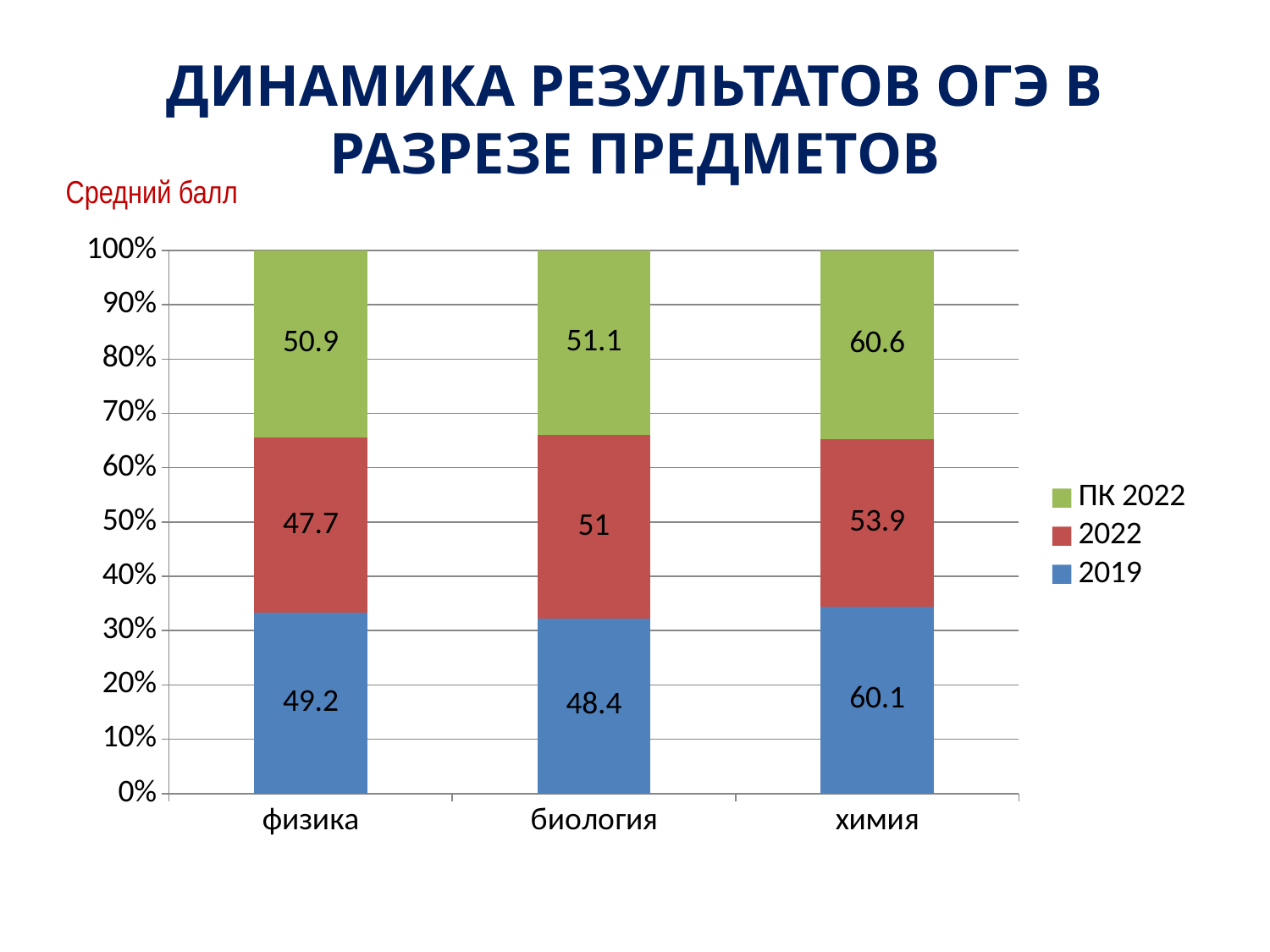
What kind of chart is shown on the slide? Stacked bar chart What is the value of the ПК 2022 series for физика? 50.9 Which subject has the highest value in the 2019 series? химия What is the value of the 2022 series for биология? 51 How many subjects are shown on the x axis? 3 How many series does the legend list? 3 Do the ПК 2022 values rise or fall from физика to химия along the x axis? Rise Which subject has the lowest value in the 2022 series? физика For физика, which is larger: the 2019 value or the 2022 value? 2019 What is the difference between the 2019 and 2022 values for химия? 6.2 What is the difference between the ПК 2022 values for химия and физика? 9.7 What is the value of the 2019 series for химия? 60.1